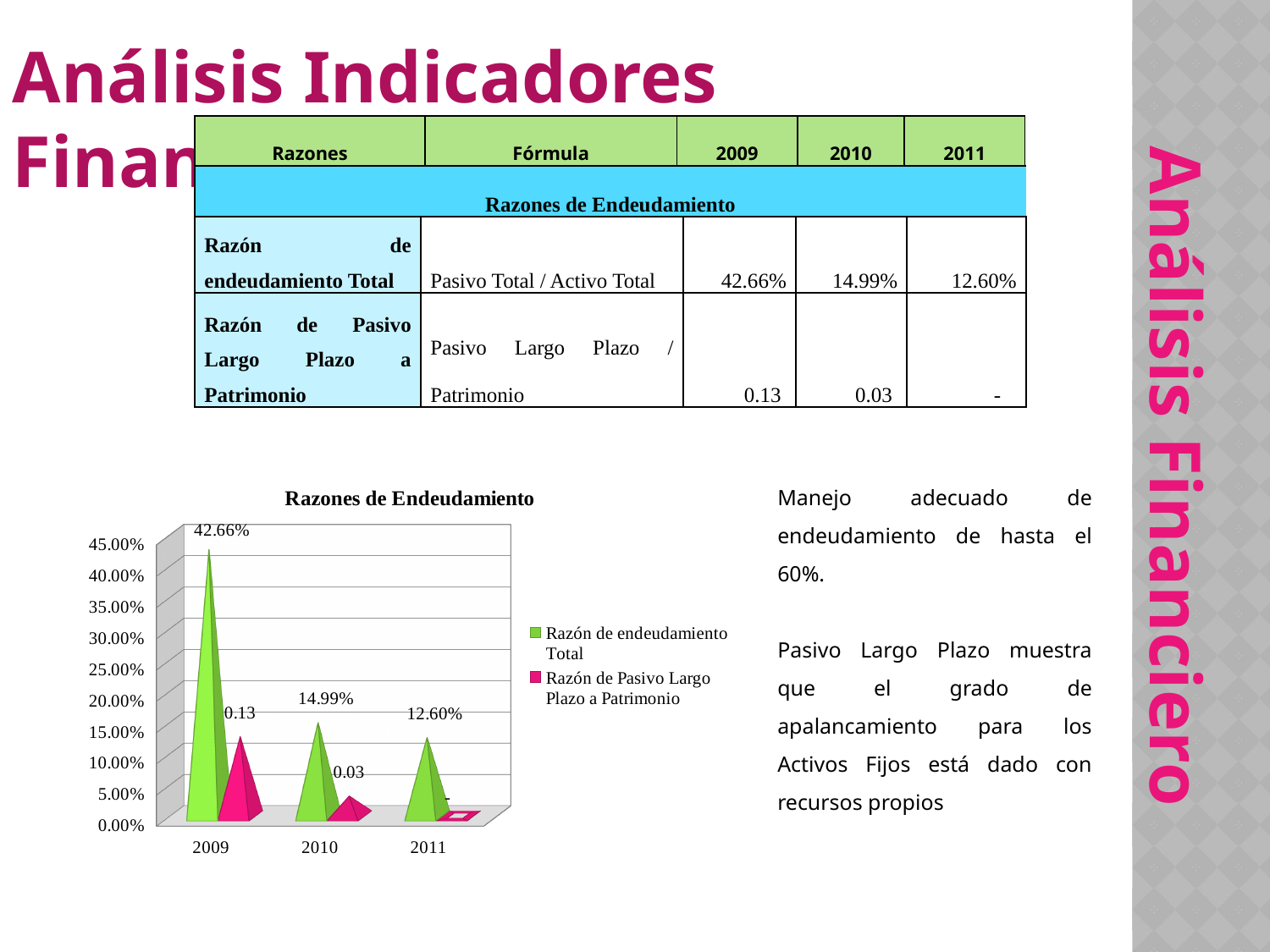
In which year is Razón de endeudamiento Total highest? 2009 What is the value of Razón de endeudamiento Total for 2011 in the chart? 12.60% What is the value of Razón de endeudamiento Total for 2009 in the chart? 42.66% What is the title of the chart? Razones de Endeudamiento Does Razón de endeudamiento Total rise or fall from 2009 to 2011? fall What is the difference between Razón de endeudamiento Total in 2009 and 2010? 27.67% What is the value of Razón de Pasivo Largo Plazo a Patrimonio for 2010 in the chart? 0.03 How many years are shown on the x axis of the chart? 3 What is the value of Razón de Pasivo Largo Plazo a Patrimonio for 2009 in the chart? 0.13 Which is larger, Razón de endeudamiento Total in 2010 or in 2011? 2010 How many series does the chart legend list? 2 In which year is Razón de endeudamiento Total lowest? 2011